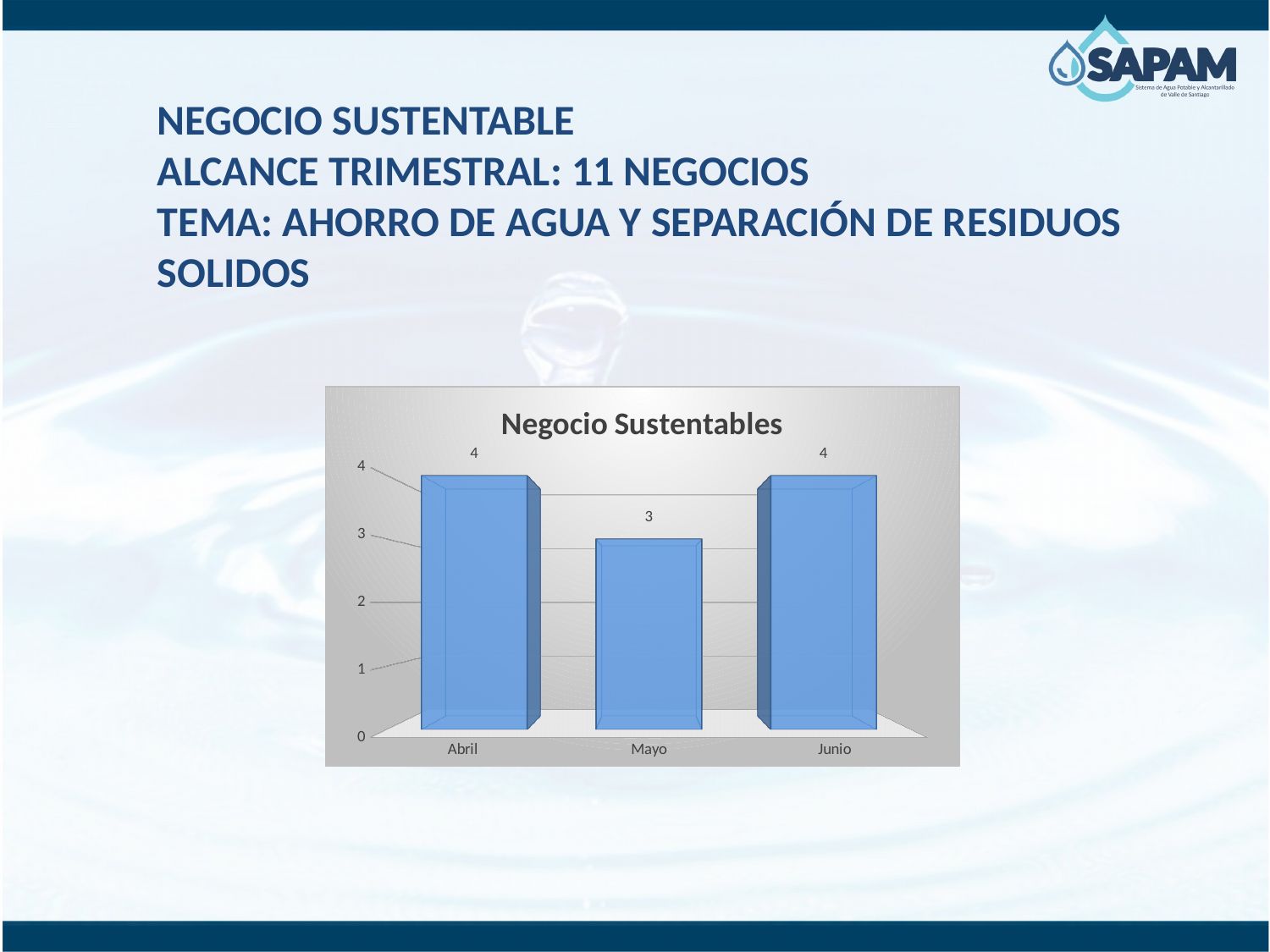
What is the value for Abril? 4 What is the value for Junio? 4 What is the title of the chart? Negocio Sustentables Is the value for Mayo greater or less than 2? greater What is the highest value shown on the y axis? 4 Which month has the lowest value? Mayo What is the value for Mayo? 3 What is the difference between the values for Abril and Mayo? 1 How many categories are shown on the x axis? 3 What is the total of the values for Abril, Mayo and Junio? 11 Which is larger, the value for Mayo or the value for Junio? Junio What kind of chart is shown? bar chart